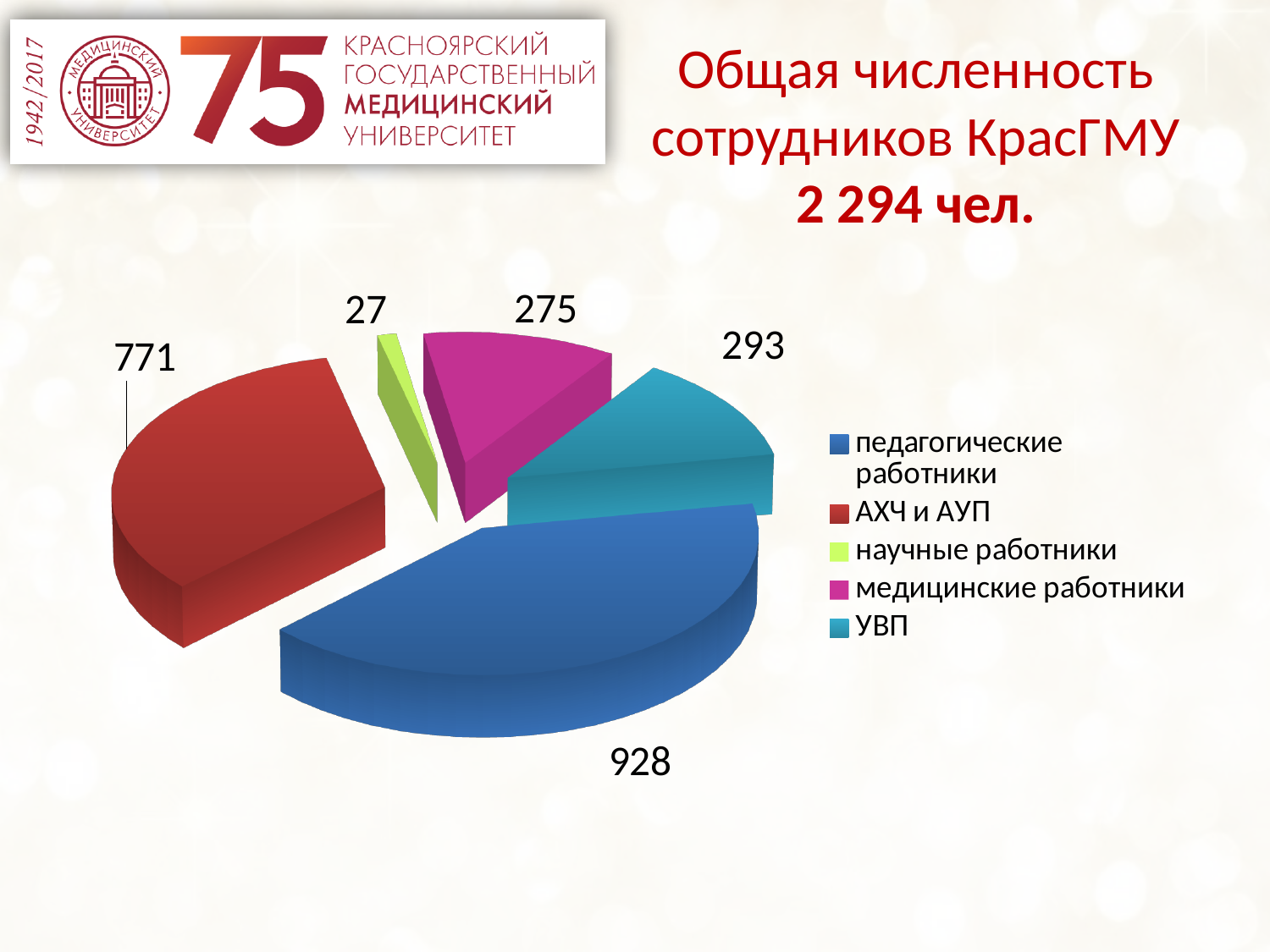
What is the value for научные работники? 27 How many categories does the pie chart have? 5 What kind of chart is shown on the slide? pie chart Which is larger, the value for УВП or the value for медицинские работники? УВП What is the value for медицинские работники? 275 Which category has the largest slice of the pie? педагогические работники What is the difference between the values for педагогические работники and АХЧ и АУП? 157 What colour is the slice for АХЧ и АУП? red What is the value for АХЧ и АУП? 771 What is the value for УВП? 293 Which category has the smallest slice of the pie? научные работники What is the value for педагогические работники? 928